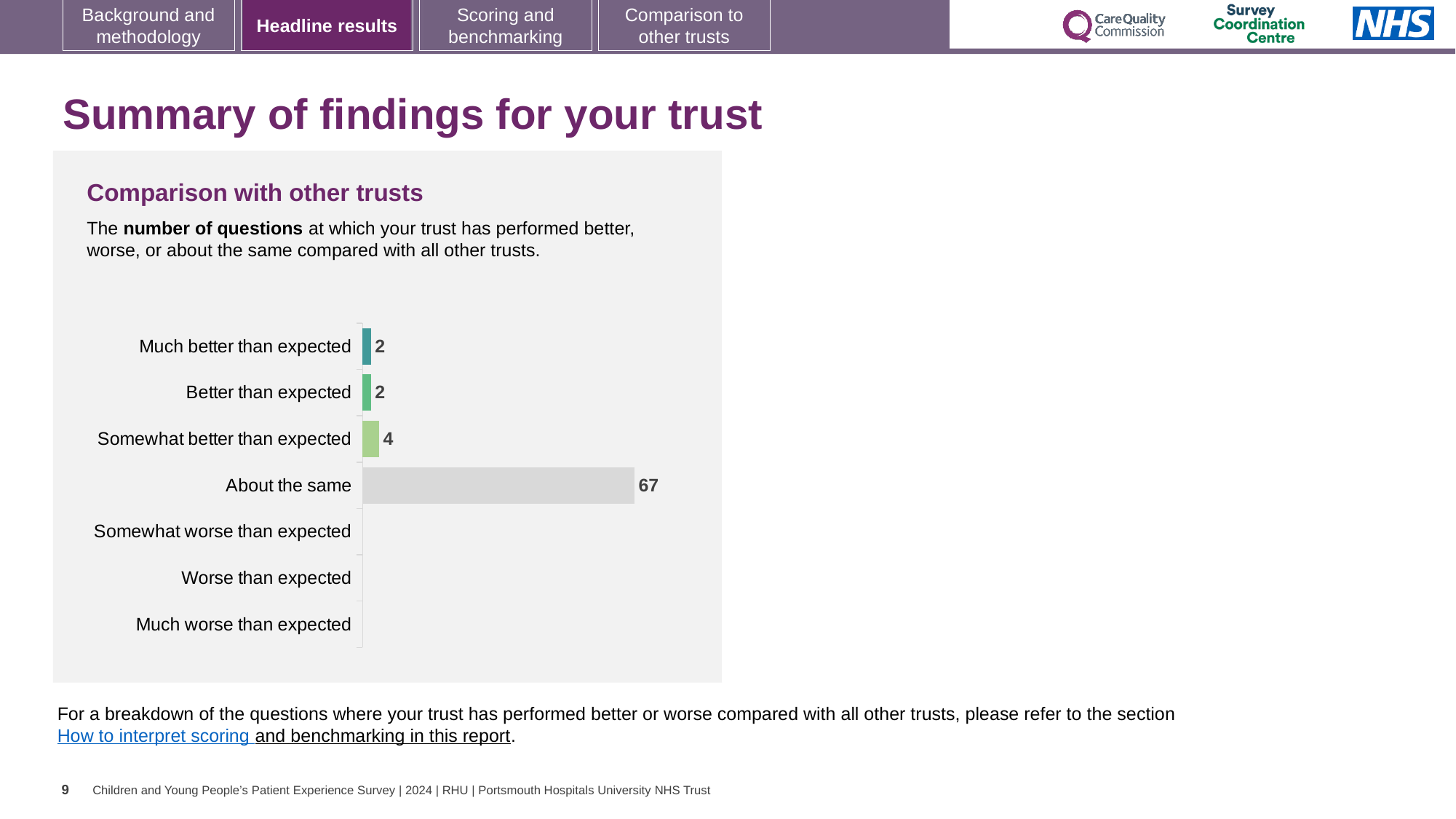
Which category has the highest number of questions? About the same What is the title of the chart? Comparison with other trusts How many categories are listed on the chart? 7 How many questions were rated 'About the same'? 67 What is the difference between 'About the same' and 'Somewhat better than expected'? 63 What is the total number of questions across the three 'better than expected' categories? 8 What kind of chart is shown on the slide? Bar chart What is the value for 'Much better than expected'? 2 Which category's bar is coloured grey? About the same Which is larger, 'Somewhat better than expected' or 'Better than expected'? Somewhat better than expected What is the value for 'Somewhat better than expected'? 4